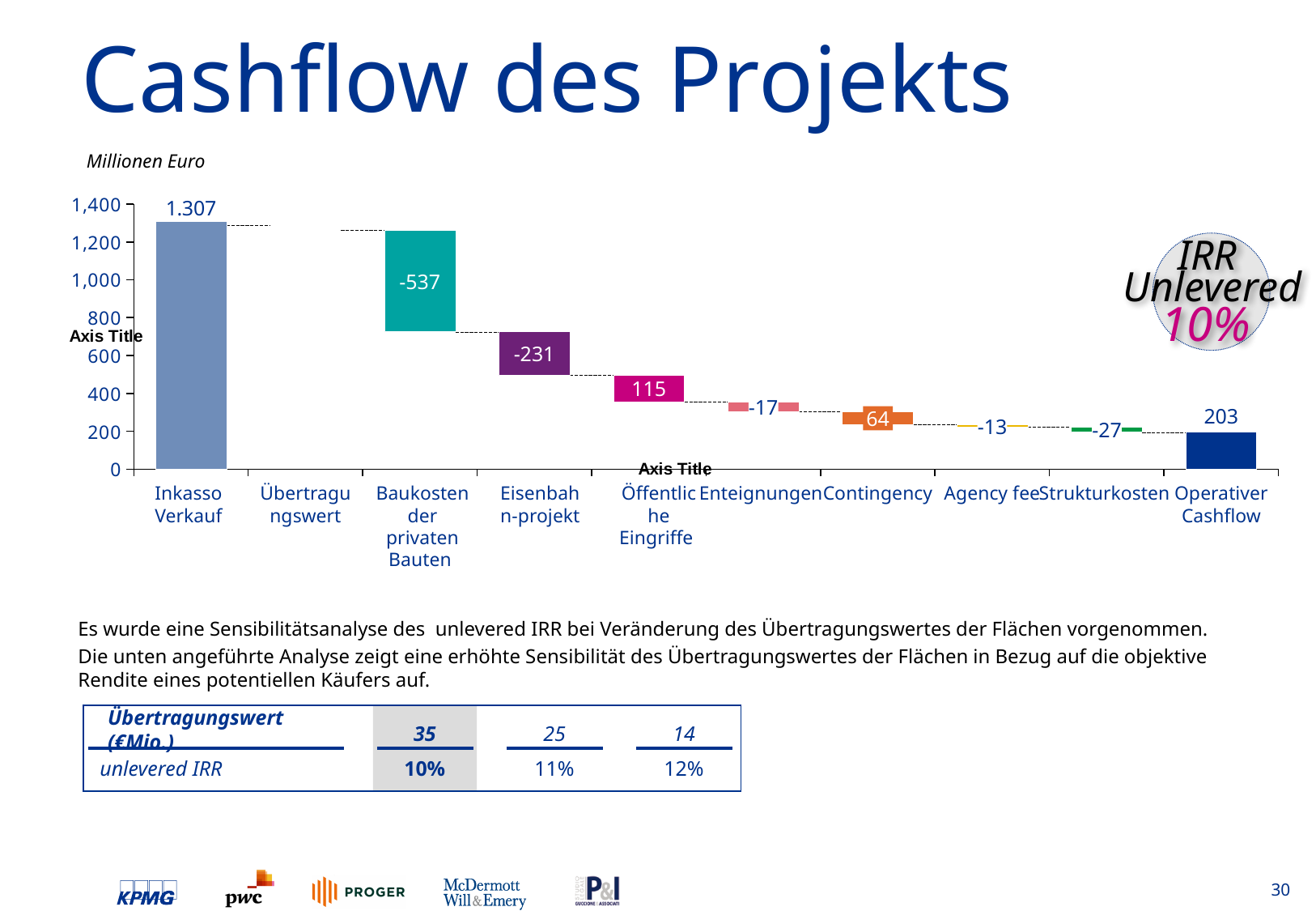
What value is shown for Contingency? 64 What value is shown for Öffentliche Eingriffe? 115 What value is shown for Baukosten der privaten Bauten? -537 What is the difference between the value for Operativer Cashflow and the value for Öffentliche Eingriffe? 88 What value is shown for Inkasso Verkauf? 1.307 Which category has the highest value in the chart? Inkasso Verkauf What value is shown for Eisenbahn-projekt? -231 How many categories are shown on the x axis of the chart? 10 What value is shown for Strukturkosten? -27 What value is shown for Operativer Cashflow? 203 What unit is stated above the chart? Millionen Euro Which is larger, the value for Öffentliche Eingriffe or the value for Contingency? Öffentliche Eingriffe